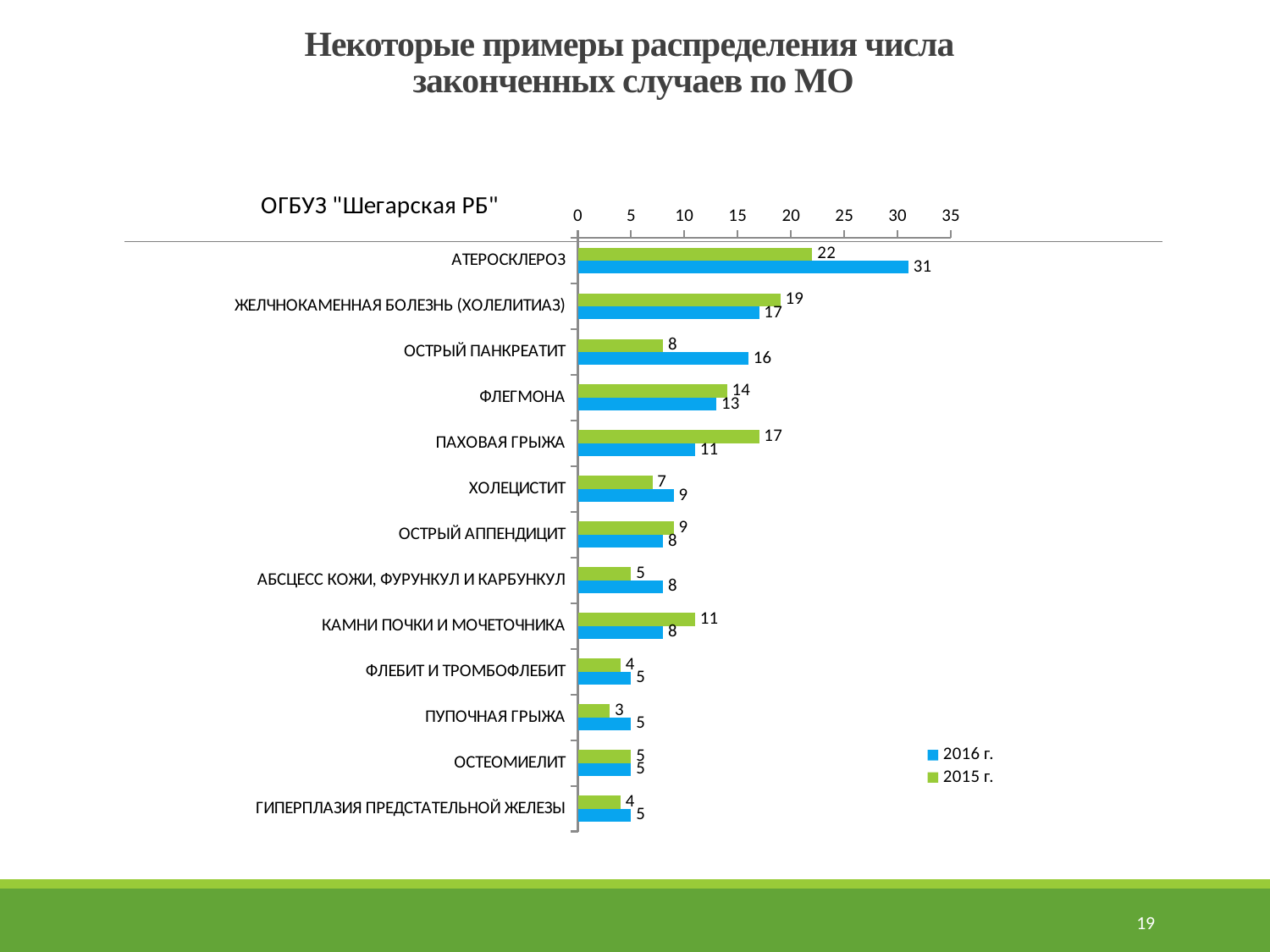
How many series does the legend list? 2 Is the 2016 г. value for АТЕРОСКЛЕРОЗ greater or less than 30? greater For ПАХОВАЯ ГРЫЖА, which year has the larger value, 2015 г. or 2016 г.? 2015 г. What is the title of the chart? ОГБУЗ "Шегарская РБ" Which category has the highest value in 2016 г.? АТЕРОСКЛЕРОЗ What is the difference between the 2016 г. and 2015 г. values for АТЕРОСКЛЕРОЗ? 9 Which category has the lowest value in 2015 г.? ПУПОЧНАЯ ГРЫЖА What is the value for АТЕРОСКЛЕРОЗ in 2016 г.? 31 What is the value for ПАХОВАЯ ГРЫЖА in 2015 г.? 17 What is the value for ОСТРЫЙ ПАНКРЕАТИТ in 2016 г.? 16 How many categories (diagnoses) are shown in the chart? 13 What type of chart is shown on the slide? Bar chart